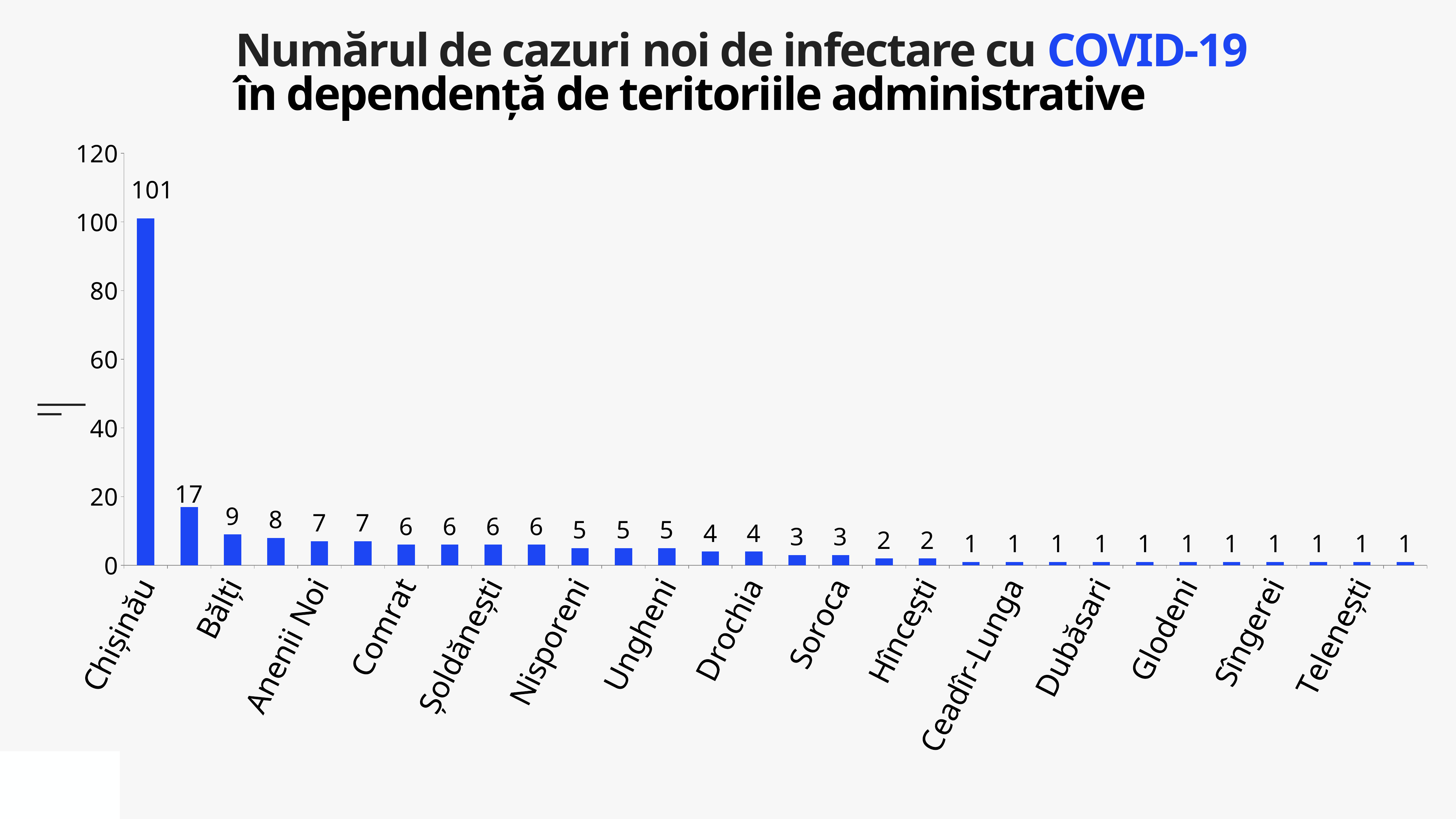
How many bars are plotted in the chart? 30 What is the value for Nisporeni? 5 What is the value for Anenii Noi? 7 What is the value for Comrat? 6 Which territory has the highest number of new cases? Chișinău What kind of chart is shown on the slide? Bar chart Do the values rise or fall from left to right along the x axis? Fall Which has a larger value, Chișinău or Bălți? Chișinău What is the value for Chișinău? 101 Is the value for Chișinău greater or less than 100? greater What is the difference between the values for Chișinău and Telenești? 100 What is the value for Telenești? 1